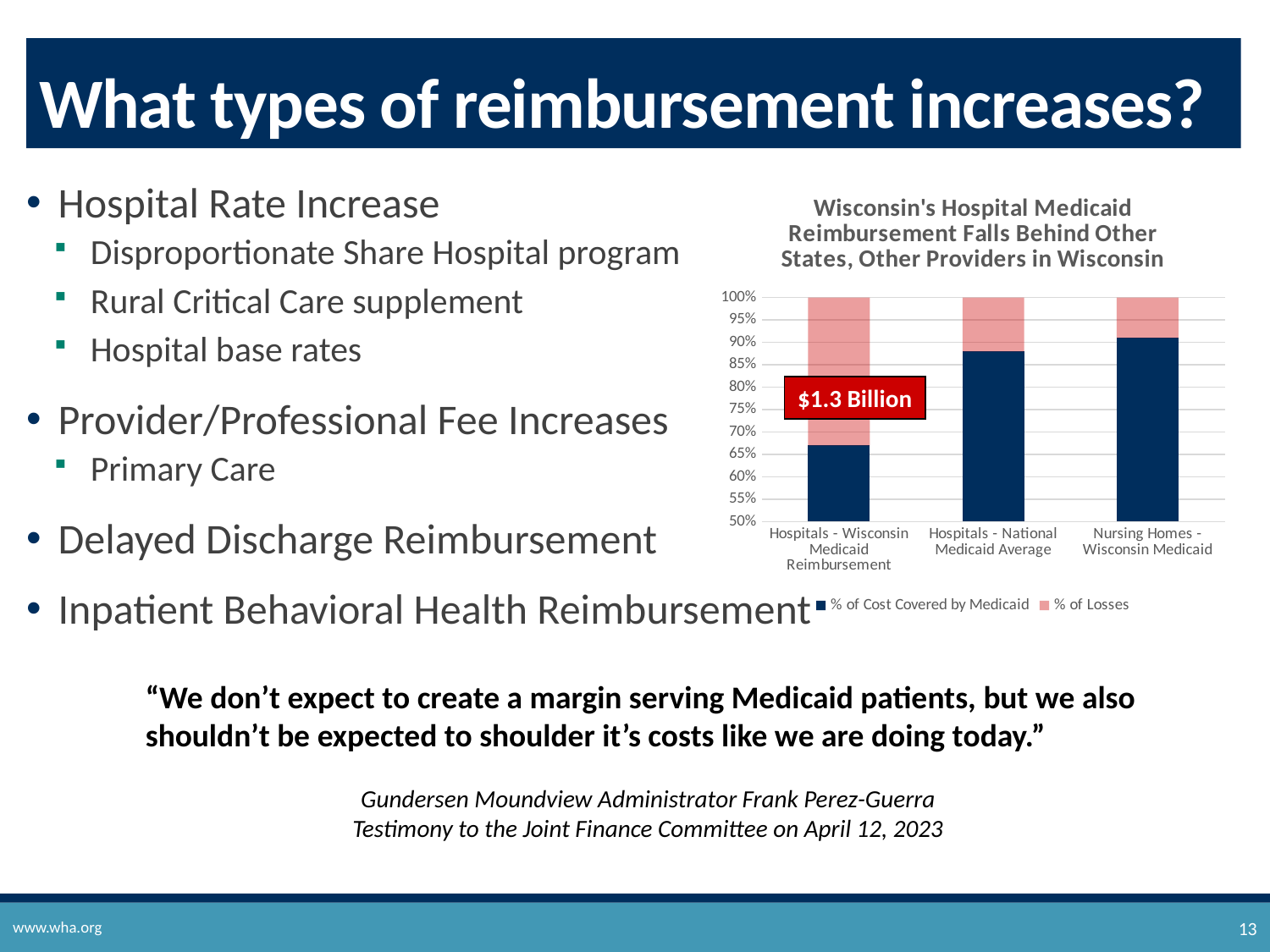
What is the title of the chart? Wisconsin's Hospital Medicaid Reimbursement Falls Behind Other States, Other Providers in Wisconsin What dollar amount is labeled on the Hospitals - Wisconsin Medicaid Reimbursement bar? $1.3 Billion Is the % of Cost Covered by Medicaid for Nursing Homes - Wisconsin Medicaid greater or less than 85%? greater Is the % of Cost Covered by Medicaid for Hospitals - National Medicaid Average greater or less than 85%? greater How many categories are shown on the x axis of the chart? 3 Is the % of Cost Covered by Medicaid for Hospitals - Wisconsin Medicaid Reimbursement greater or less than 70%? less Which has a larger % of Cost Covered by Medicaid: Hospitals - Wisconsin Medicaid Reimbursement or Hospitals - National Medicaid Average? Hospitals - National Medicaid Average What total does each stacked bar reach on the y axis? 100% What type of chart is shown on the slide? Stacked bar chart Which category has the lowest % of Cost Covered by Medicaid? Hospitals - Wisconsin Medicaid Reimbursement Which category has the highest % of Cost Covered by Medicaid? Nursing Homes - Wisconsin Medicaid How many series does the chart's legend list? 2